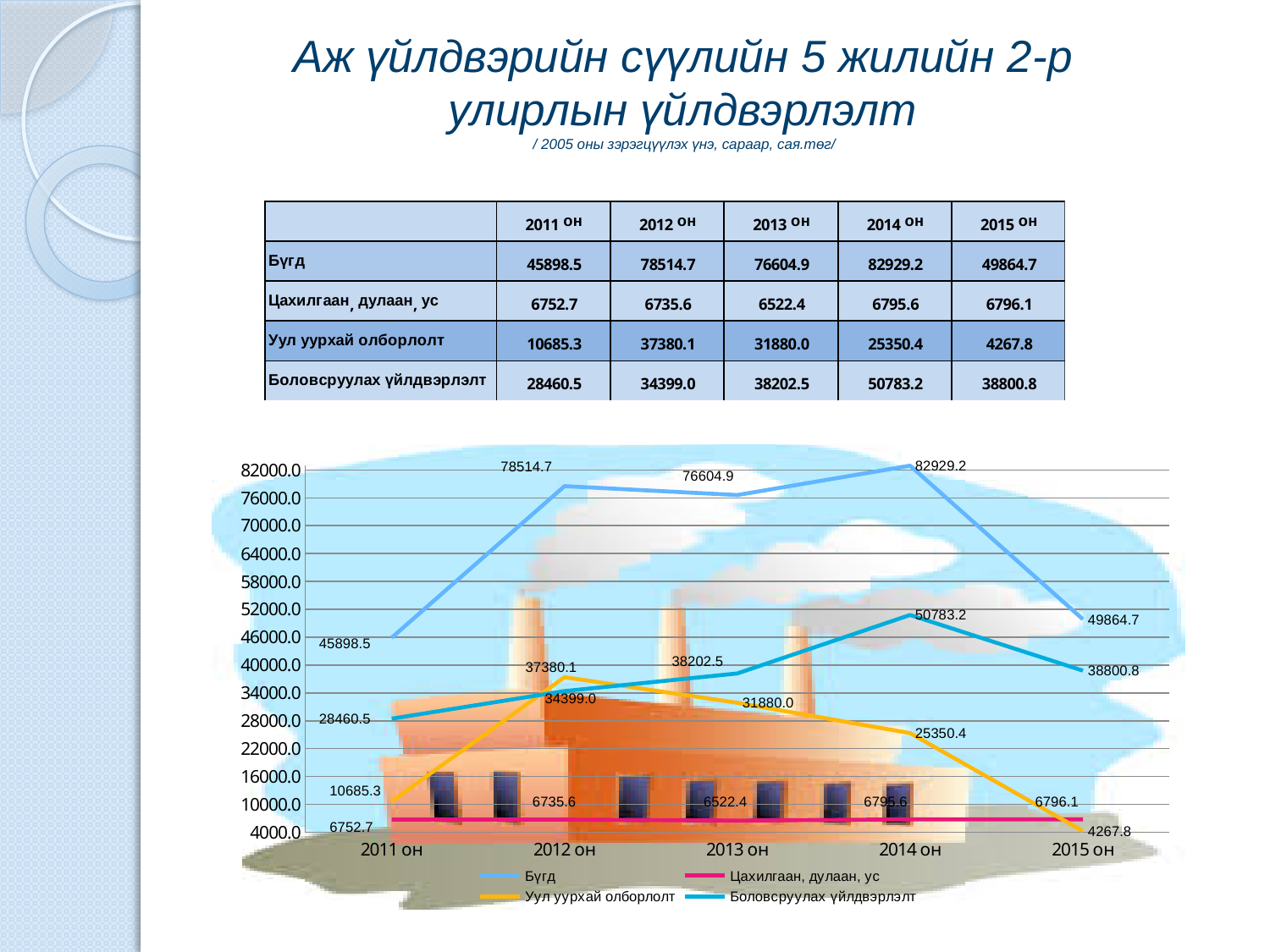
How many years are shown on the x axis of the chart? 5 What is the value of Уул уурхай олборлолт for 2015 он? 4267.8 Is the value of Боловсруулах үйлдвэрлэлт for 2014 он greater or less than 46000.0? greater In which year is the Уул уурхай олборлолт series lowest? 2015 он How many series does the chart legend list? 4 In which year is the Бүгд series highest? 2014 он What is the difference between the Бүгд values for 2014 он and 2015 он? 33064.5 Does the Уул уурхай олборлолт series rise or fall from 2012 он to 2015 он? fall What type of chart is shown on the slide? line chart Which is larger in 2012 он: Уул уурхай олборлолт or Боловсруулах үйлдвэрлэлт? Уул уурхай олборлолт What is the value of Бүгд for 2014 он? 82929.2 What is the value of Боловсруулах үйлдвэрлэлт for 2013 он? 38202.5